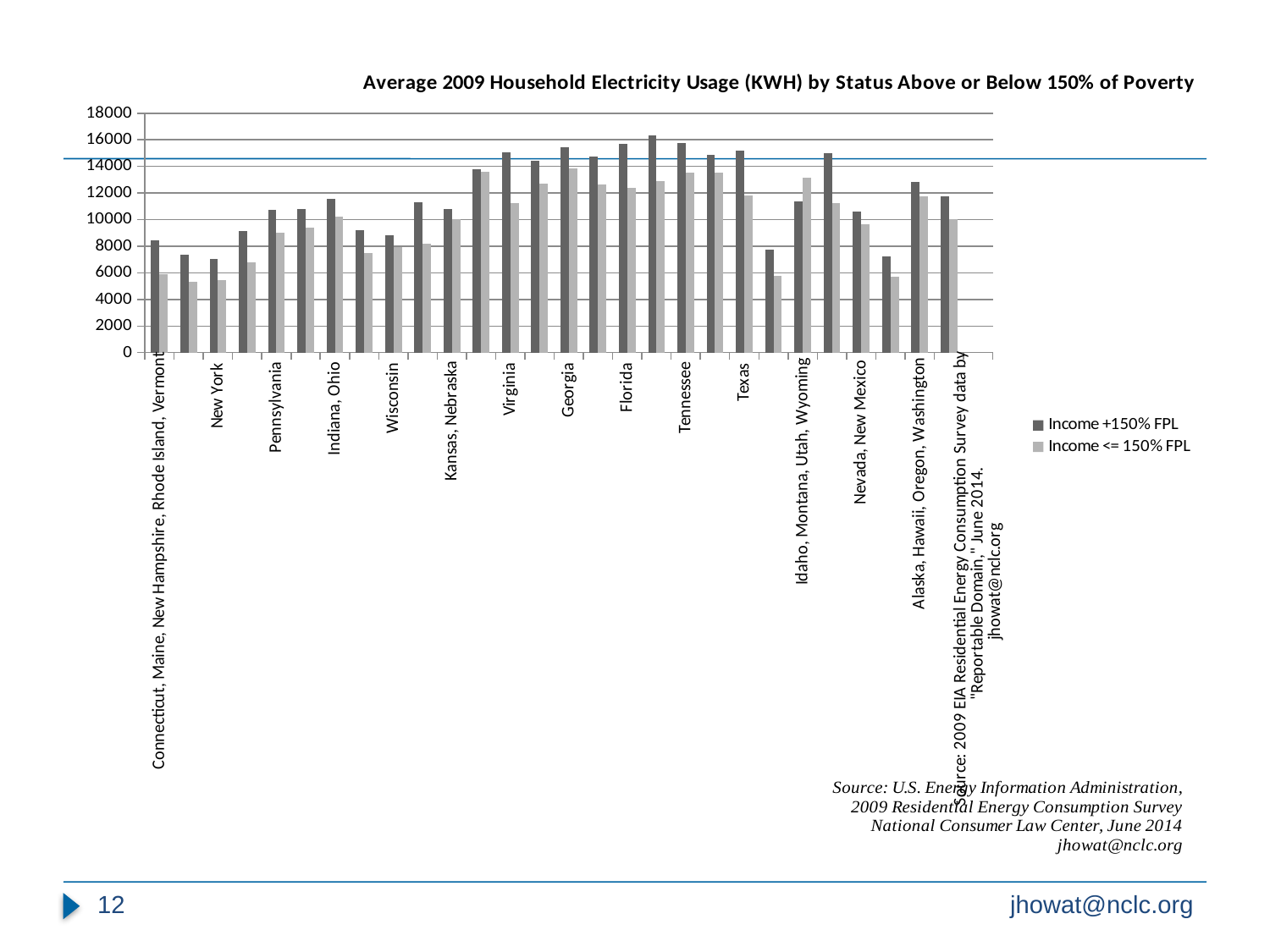
What is the title of the chart? Average 2009 Household Electricity Usage (KWH) by Status Above or Below 150% of Poverty Is the Income +150% FPL value for Virginia greater or less than 14000? greater Is the Income <= 150% FPL value for Pennsylvania greater or less than 10000? less Is the Income <= 150% FPL value for Idaho, Montana, Utah, Wyoming greater or less than 12000? greater What kind of chart is shown on the slide? bar chart How many series does the legend list? 2 For Florida, which series has the larger value: Income +150% FPL or Income <= 150% FPL? Income +150% FPL For Idaho, Montana, Utah, Wyoming, which series has the larger value: Income +150% FPL or Income <= 150% FPL? Income <= 150% FPL Which legend entry is shown in the lighter grey colour? Income <= 150% FPL